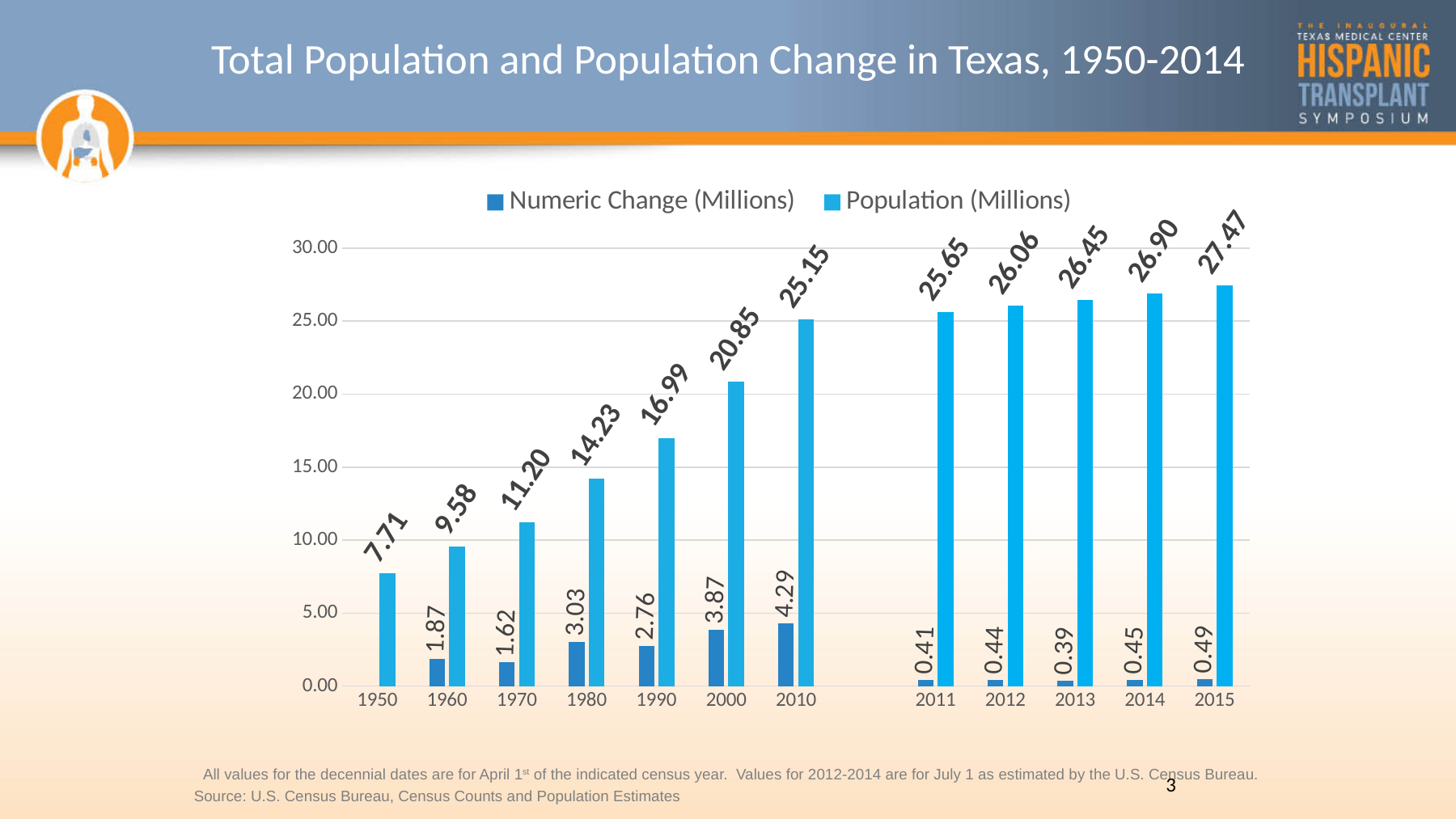
What is the difference between the Population (Millions) values for 2015 and 2014? 0.57 Which year has the lowest Numeric Change (Millions) value? 2013 How many years are labelled on the x axis? 12 What is the Numeric Change (Millions) value for 1980? 3.03 Which is larger, the Numeric Change (Millions) for 1960 or for 1970? 1960 What kind of chart is shown on the slide? Bar chart Do the Population (Millions) values rise or fall from 1950 to 2015? Rise How many series does the legend list? 2 Is the Population (Millions) value for 1990 greater or less than 15.00? greater Which year has the highest Population (Millions) value? 2015 What is the Population (Millions) value for 2010? 25.15 What is the Population (Millions) value for 1950? 7.71